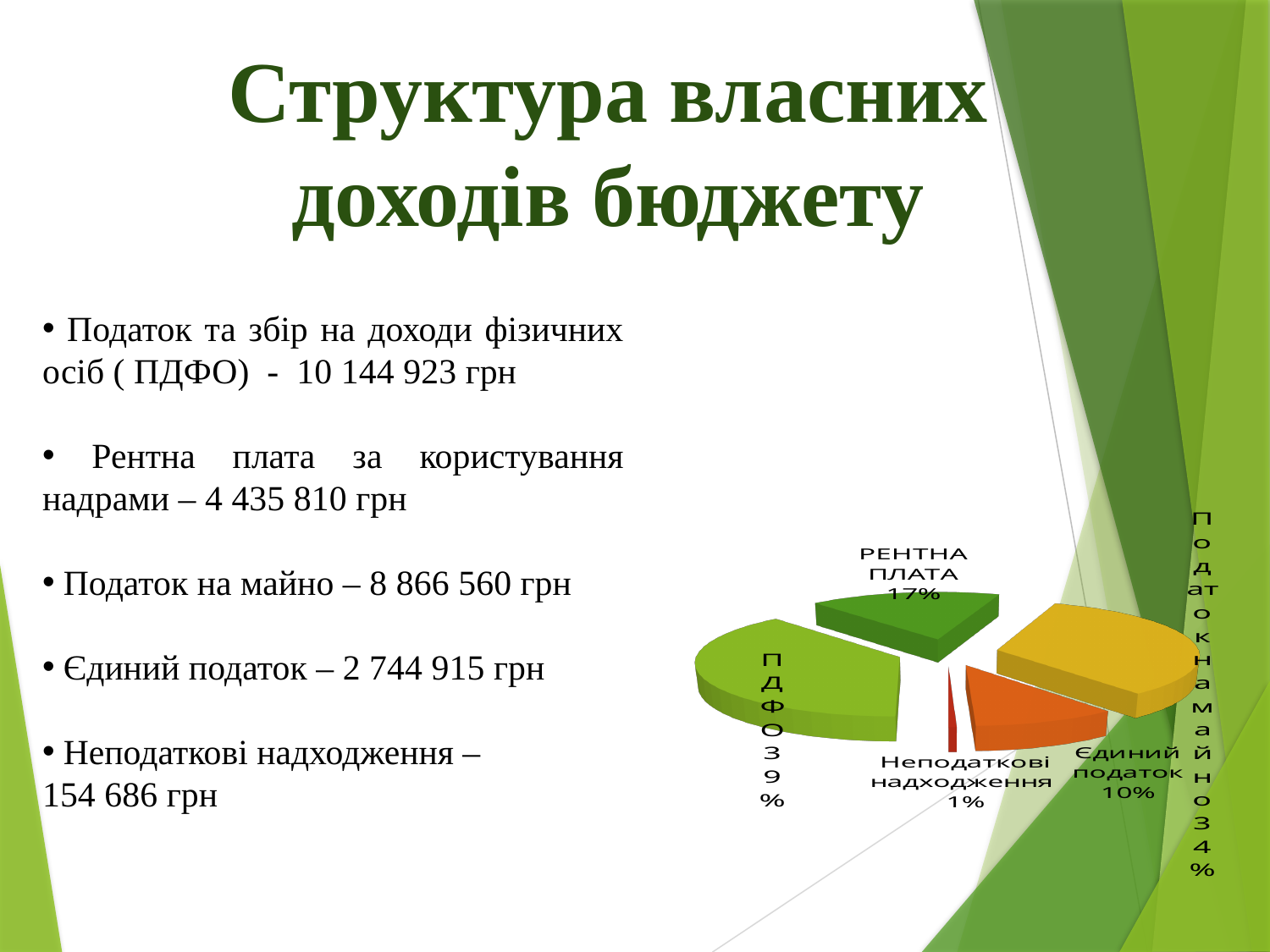
What percentage is shown for Єдиний податок in the pie chart? 10% What kind of chart is shown on the slide? pie chart What share of the pie do Неподаткові надходження account for? 1% Which category has the smallest slice in the pie chart? Неподаткові надходження Which is larger in the pie chart, РЕНТНА ПЛАТА or Єдиний податок? РЕНТНА ПЛАТА Which category is shown as the yellow slice in the pie chart? Податок на майно What percentage is shown for Податок на майно in the pie chart? 34% What is the difference in percentage points between ПДФО and Податок на майно? 5 How many slices does the pie chart have? 5 Which category has the largest slice in the pie chart? ПДФО What share of the pie does ПДФО account for? 39% What percentage is shown for РЕНТНА ПЛАТА in the pie chart? 17%